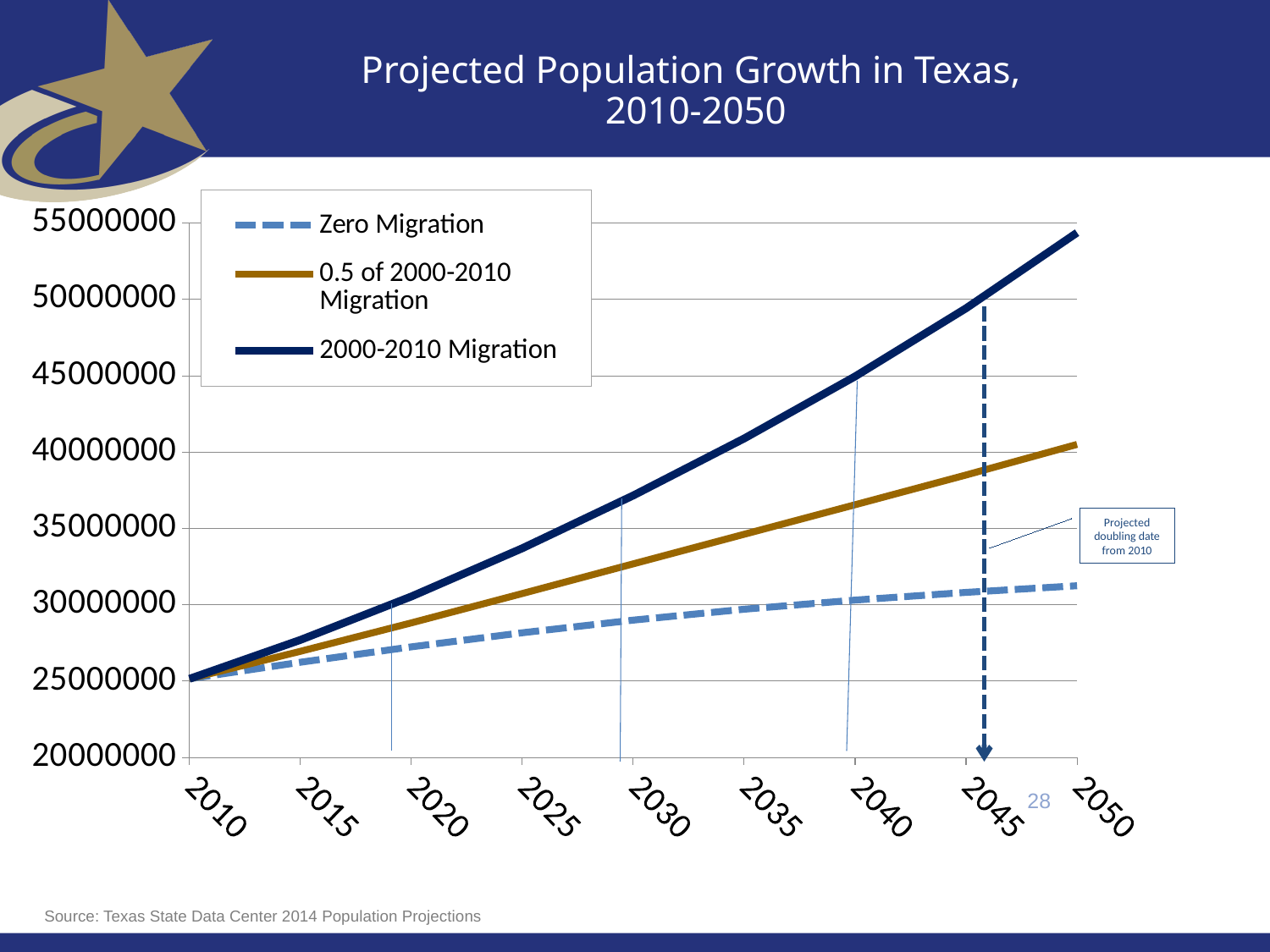
Do the values for the 2000-2010 Migration series rise or fall from 2010 to 2050? rise What kind of chart is shown on the slide? line chart In which year does the dashed vertical arrow mark the projected doubling date from 2010? 2045 Is the value for 2000-2010 Migration in 2050 greater or less than 50000000? greater How many year labels are shown on the x axis? 9 Which series has the lowest value in 2050? Zero Migration Is the value for 0.5 of 2000-2010 Migration in 2050 greater or less than 45000000? less In 2030, which is larger: the 2000-2010 Migration value or the Zero Migration value? 2000-2010 Migration Is the value for Zero Migration in 2050 greater or less than 35000000? less How many series does the legend list? 3 What is the title of the chart? Projected Population Growth in Texas, 2010-2050 Which series has the highest value in 2050? 2000-2010 Migration